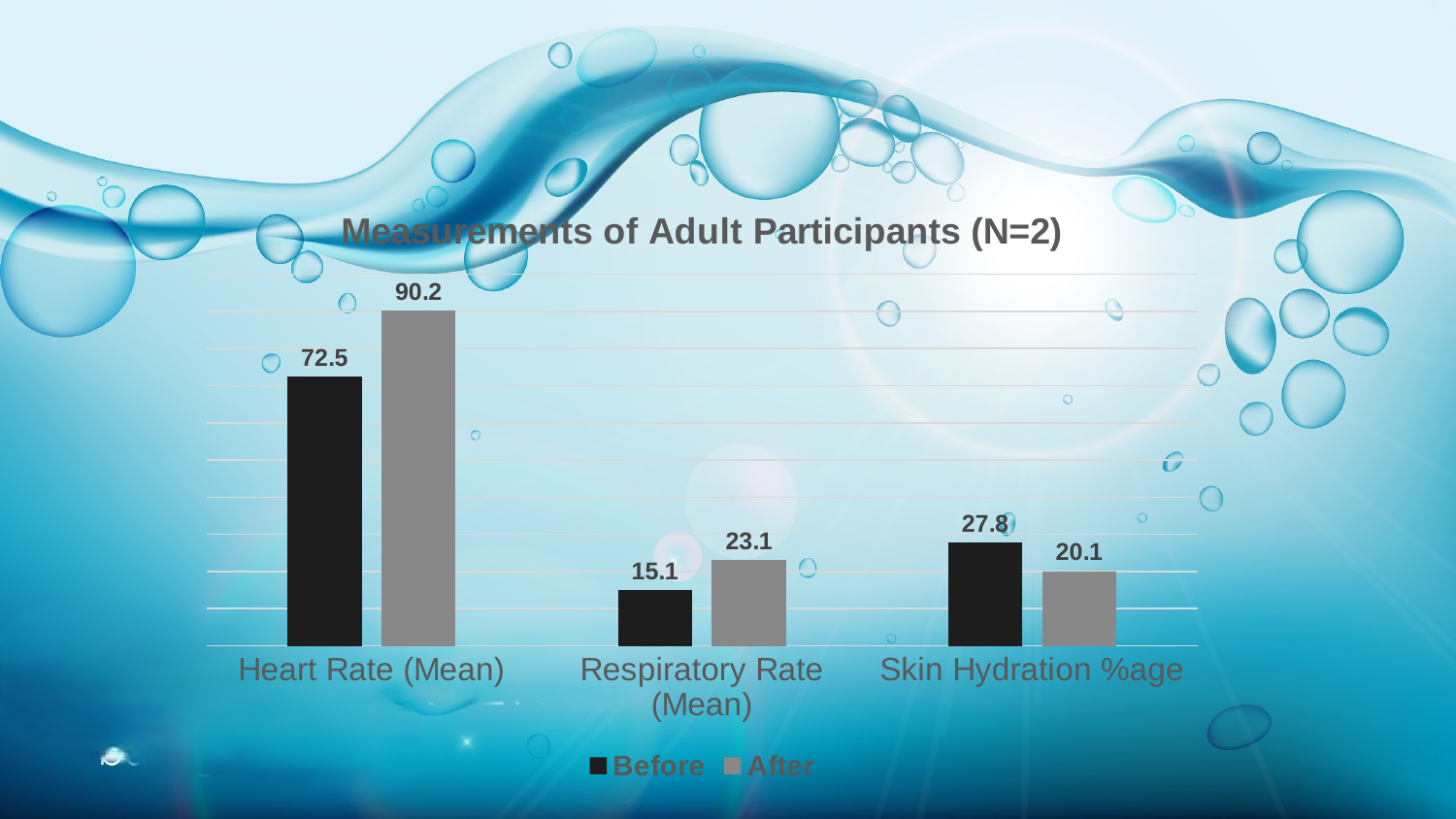
How many series does the legend list? 2 What is the Before value for Respiratory Rate (Mean)? 15.1 Which category has the lowest Before value? Respiratory Rate (Mean) How many categories are shown on the x axis? 3 For Respiratory Rate (Mean), which is larger, the Before or the After value? After What is the After value for Skin Hydration %age? 20.1 What is the difference between the After and Before values for Heart Rate (Mean)? 17.7 What is the Before value for Heart Rate (Mean)? 72.5 Which category has the highest After value? Heart Rate (Mean) What is the title of the chart? Measurements of Adult Participants (N=2) What is the After value for Heart Rate (Mean)? 90.2 What is the difference between the Before and After values for Skin Hydration %age? 7.7